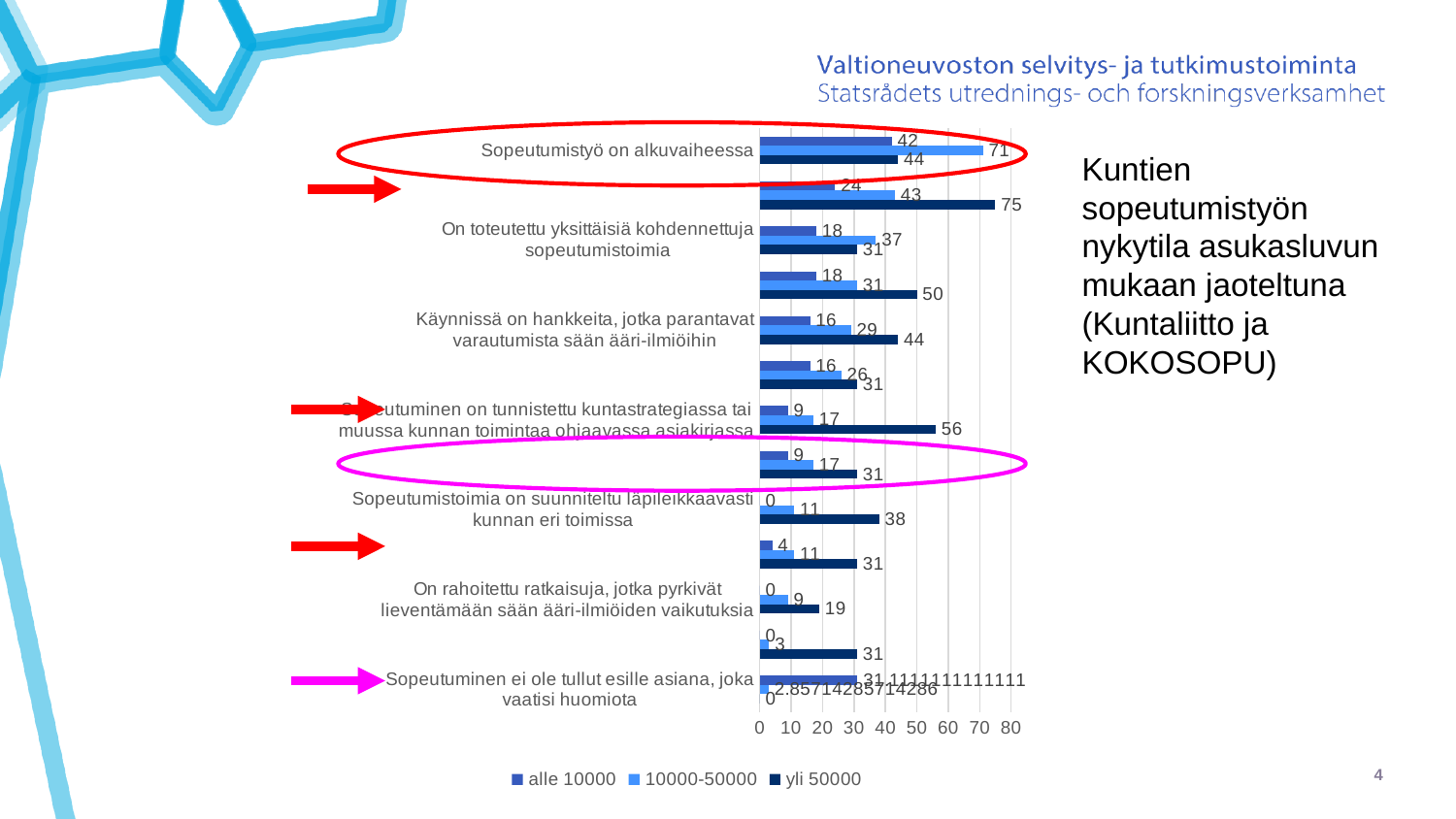
What is the value for the yli 50000 series for "Sopeutumistyö on alkuvaiheessa"? 44 What kind of chart is shown on the slide? bar chart For "Käynnissä on hankkeita, jotka parantavat varautumista sään ääri-ilmiöihin", which is larger: the alle 10000 value or the yli 50000 value? yli 50000 How many series does the legend list? 3 What is the highest value shown on the x axis of the chart? 80 What is the value for the 10000-50000 series for "Sopeutumistyö on alkuvaiheessa"? 71 What is the value for the yli 50000 series for "Sopeutuminen on tunnistettu kuntastrategiassa tai muussa kunnan toimintaa ohjaavassa asiakirjassa"? 56 What is the difference between the 10000-50000 value and the alle 10000 value for "Sopeutumistyö on alkuvaiheessa"? 29 What are the three series named in the legend? alle 10000, 10000-50000, yli 50000 What is the value for the alle 10000 series for "Sopeutumistyö on alkuvaiheessa"? 42 Which series has the highest value for "Sopeutumistyö on alkuvaiheessa"? 10000-50000 What is the value for the alle 10000 series for "Sopeutuminen ei ole tullut esille asiana, joka vaatisi huomiota"? 31.1111111111111